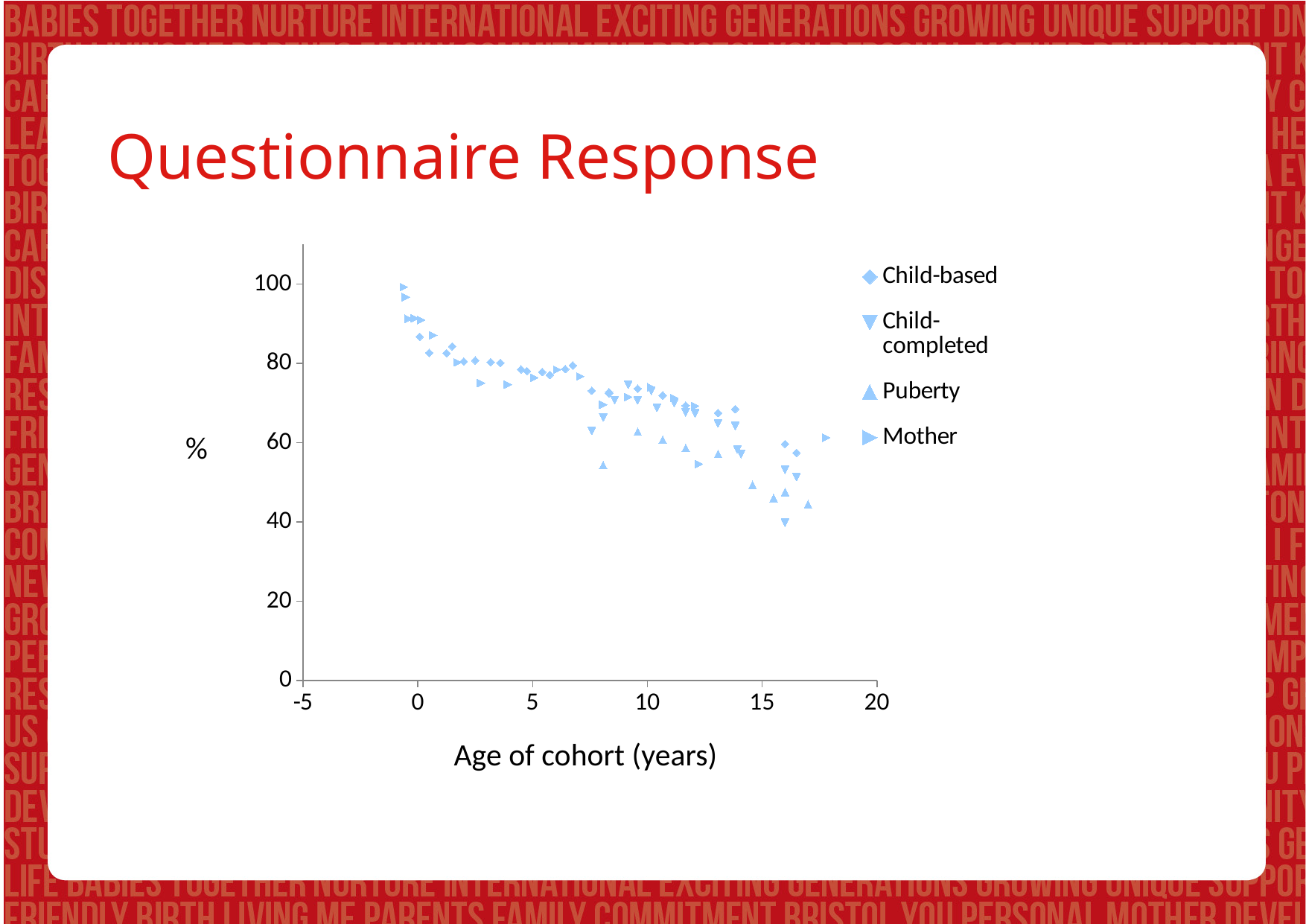
Is the Mother value plotted at about age -1 greater or less than 80? greater Is the Puberty value plotted at about age 17 greater or less than 60? less Is the Child-based value plotted at about age 14 greater or less than 80? less What kind of chart is shown on the slide? Scatter chart Do the plotted response percentages generally rise or fall as the age of cohort increases? Fall How many series does the legend list? 4 What is the title of the slide containing the chart? Questionnaire Response What is the label of the x axis? Age of cohort (years)